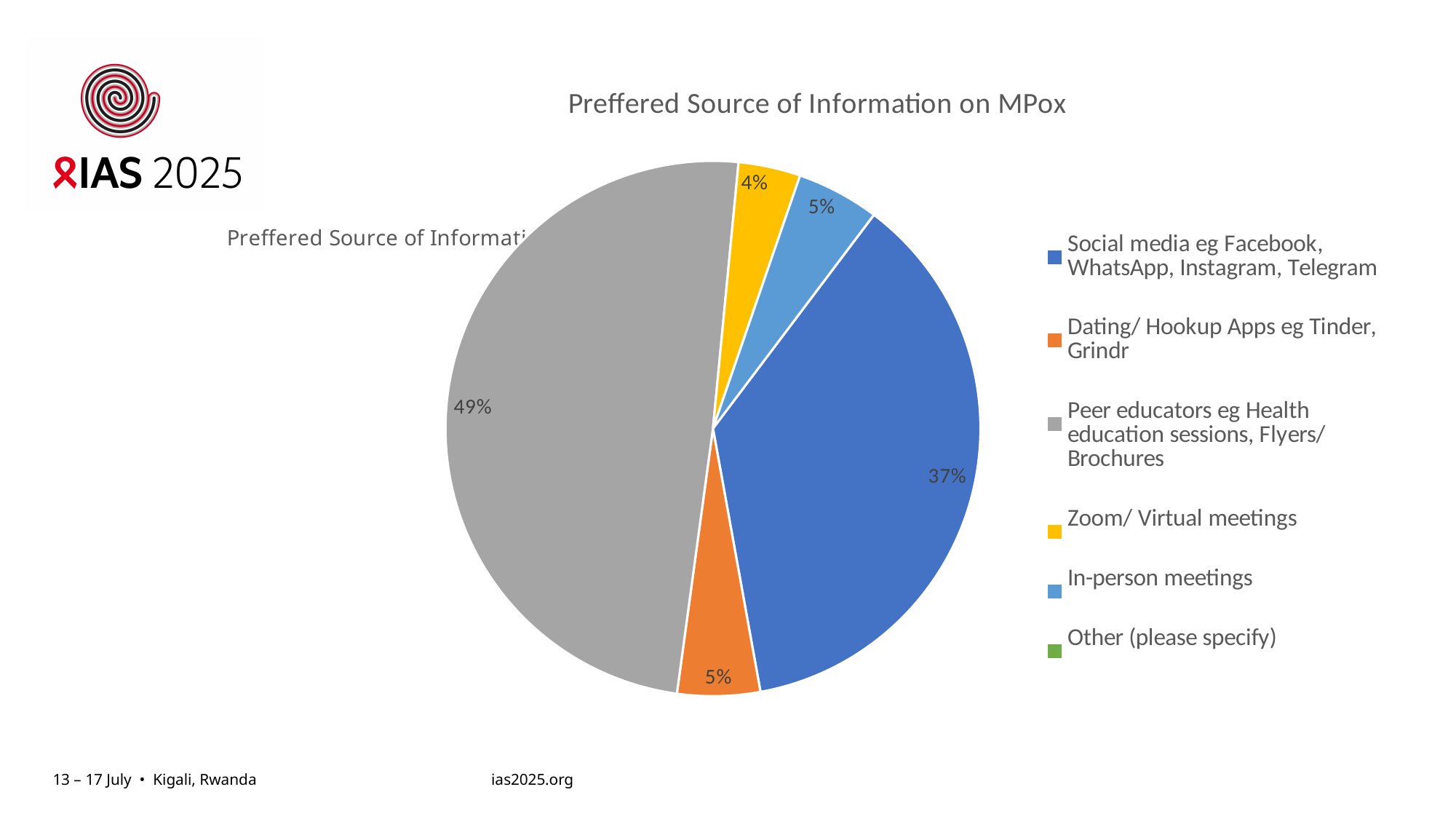
What is the title of the pie chart? Preffered Source of Information on MPox What share of the pie is labelled for Zoom/ Virtual meetings? 4% What share of the pie is labelled for Peer educators eg Health education sessions, Flyers/ Brochures? 49% What kind of chart is shown on the slide? pie chart What share of the pie is labelled for Social media eg Facebook, WhatsApp, Instagram, Telegram? 37% How many entries does the legend of the pie chart list? 6 Which is larger, the Social media slice or the Dating/ Hookup Apps slice? Social media eg Facebook, WhatsApp, Instagram, Telegram Which labelled slice of the pie is the smallest? Zoom/ Virtual meetings Which source of information has the largest slice of the pie? Peer educators eg Health education sessions, Flyers/ Brochures What is the difference in percentage points between the Peer educators slice and the Social media slice? 12